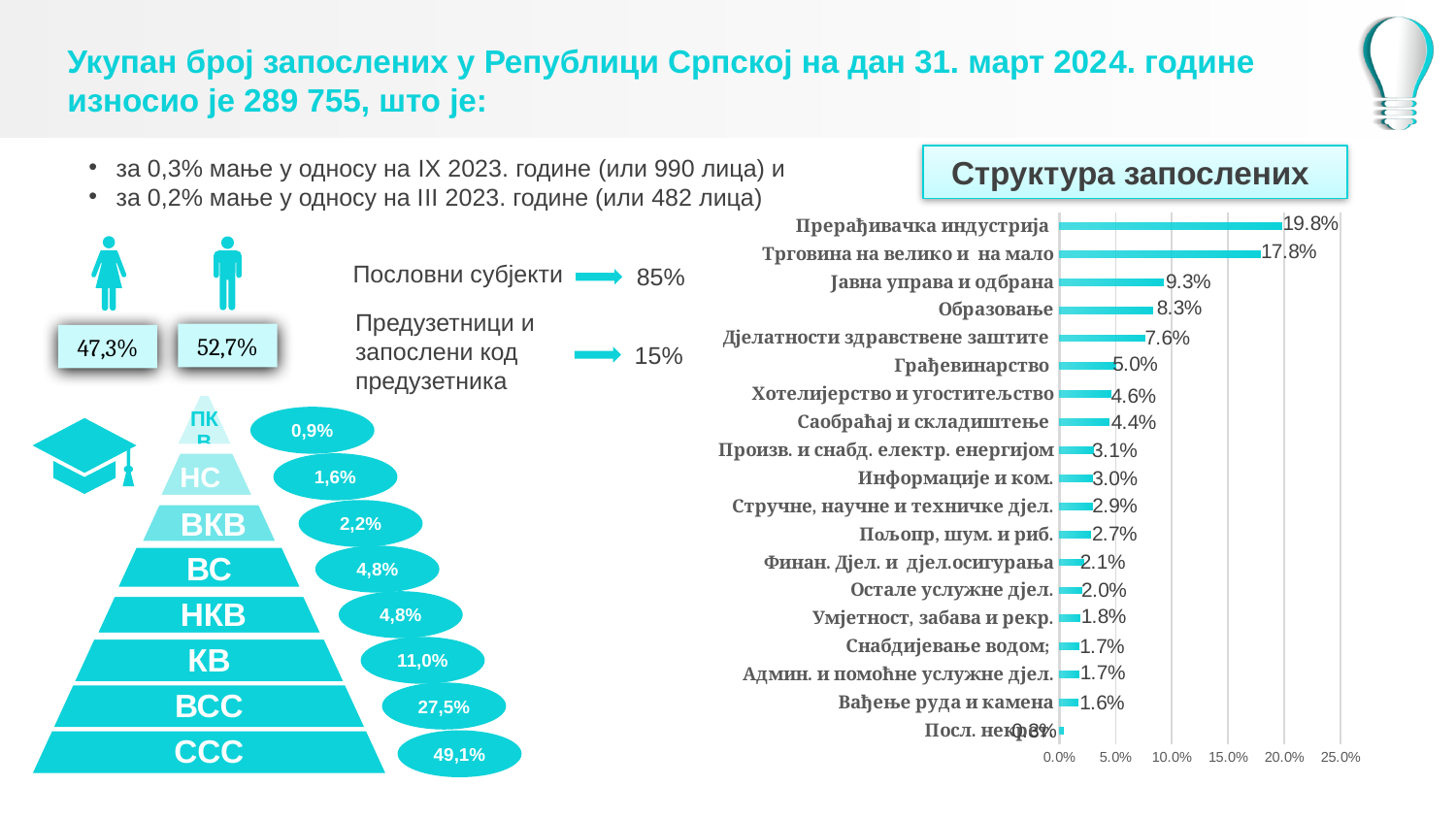
What is the title of the bar chart on the right side of the slide? Структура запослених What is the value for Образовање in the Структура запослених chart? 8.3% How many categories are shown in the Структура запослених chart? 19 What is the difference between Прерађивачка индустрија and Трговина на велико и на мало in the Структура запослених chart? 2.0% What kind of chart is the Структура запослених chart? bar chart In the Структура запослених chart, is the value for Трговина на велико и на мало greater or less than 15.0%? greater In the Структура запослених chart, do the values increase or decrease going from the top category to the bottom category? decrease What is the value for Прерађивачка индустрија in the Структура запослених chart? 19.8% In the Структура запослених chart, which is larger: Јавна управа и одбрана or Дјелатности здравствене заштите? Јавна управа и одбрана Which category has the highest value in the Структура запослених chart? Прерађивачка индустрија What is the value for Вађење руда и камена in the Структура запослених chart? 1.6% What is the value for Грађевинарство in the Структура запослених chart? 5.0%